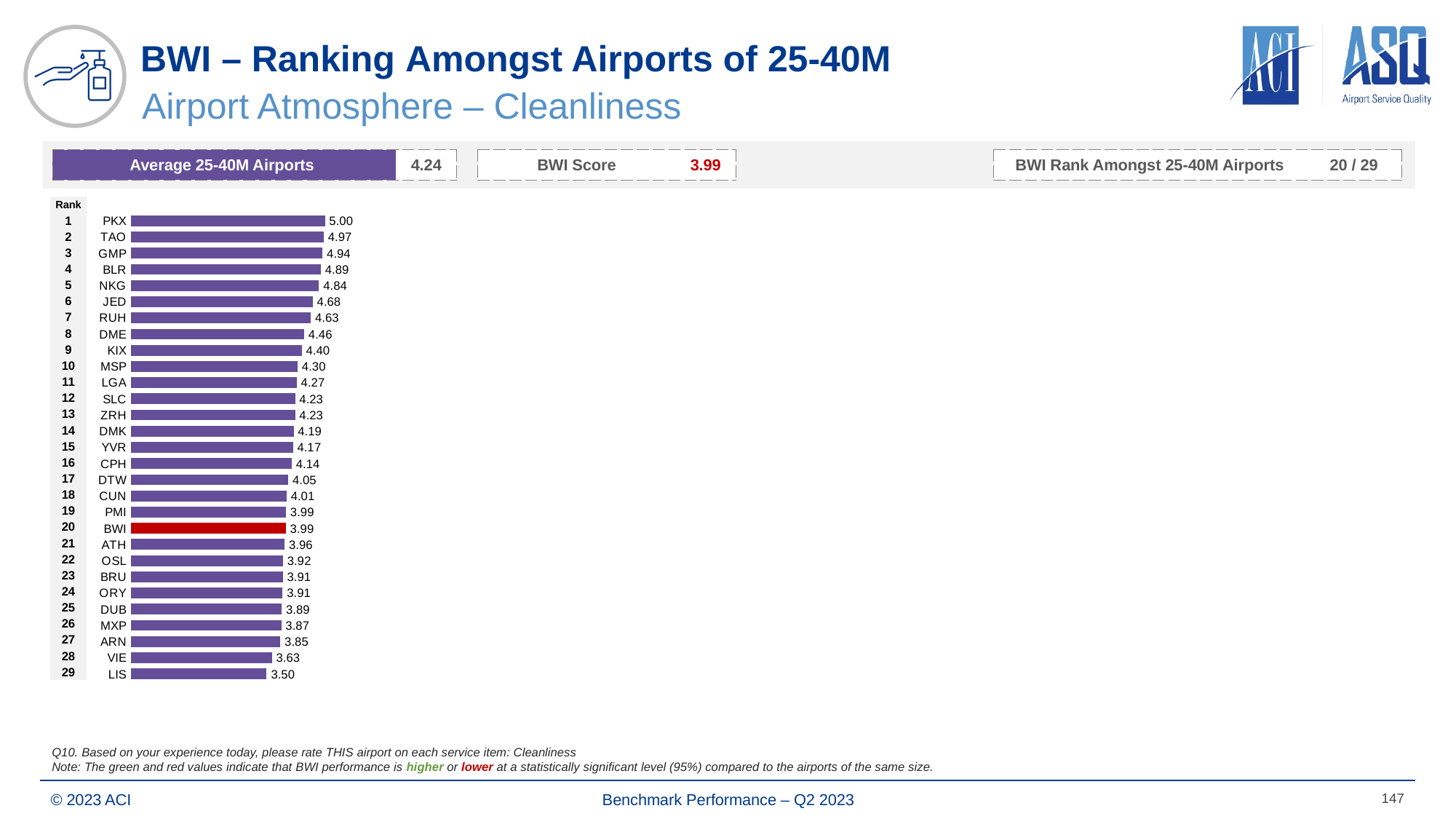
How many airports are ranked in the chart? 29 What is the difference between the scores of PKX and LIS? 1.50 What is the score for KIX? 4.40 Which airport's bar is coloured red in the chart? BWI Which airport has the highest score? PKX Which airport has the lowest score? LIS Do the scores rise or fall as you go down the ranking from rank 1 to rank 29? Fall What is the score for VIE? 3.63 What is the cleanliness score for BWI? 3.99 What is the difference between the score of MSP and the score of BWI? 0.31 What kind of chart is shown on the slide? Bar chart Which has a higher score, JED or DME? JED